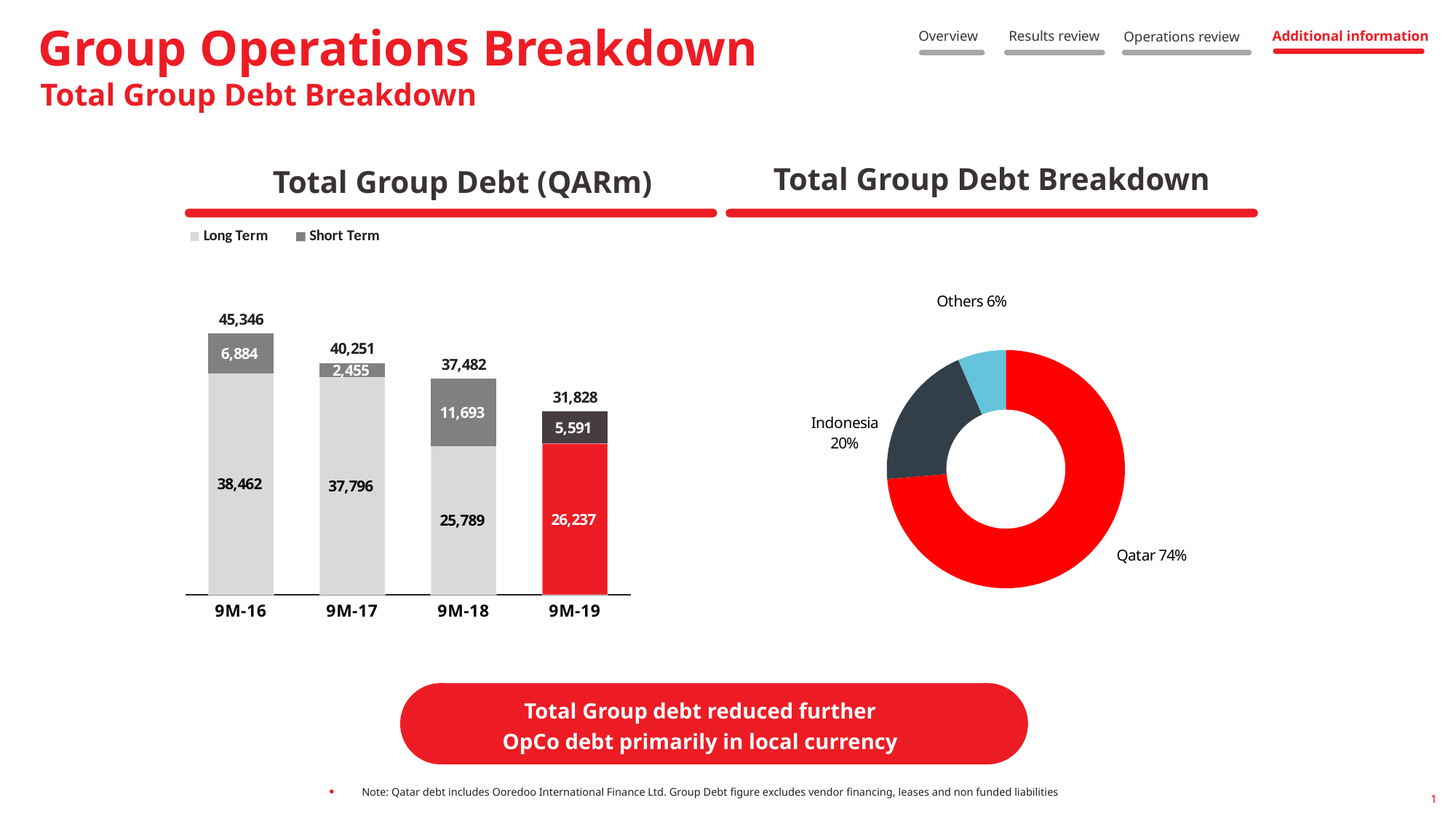
In the Total Group Debt Breakdown chart, what share of debt is attributed to Qatar? 74% In the Total Group Debt (QARm) chart, which period has the highest total debt? 9M-16 In the Total Group Debt (QARm) chart, how many periods are shown on the x axis? 4 In the Total Group Debt (QARm) chart, which period has the lowest Short Term value? 9M-17 In the Total Group Debt (QARm) chart, how many series does the legend list? 2 In the Total Group Debt (QARm) chart, does total debt rise or fall from 9M-16 to 9M-19? fall In the Total Group Debt (QARm) chart, what is the difference between the total debt in 9M-16 and 9M-19? 13,518 In the Total Group Debt (QARm) chart, what is the Short Term value for 9M-18? 11,693 In the Total Group Debt (QARm) chart, is the Long Term value larger in 9M-18 or 9M-19? 9M-19 In the Total Group Debt (QARm) chart, what is the total debt for 9M-19? 31,828 In the Total Group Debt (QARm) chart, what is the Long Term value for 9M-16? 38,462 What kind of chart is the Total Group Debt Breakdown chart? donut (pie) chart